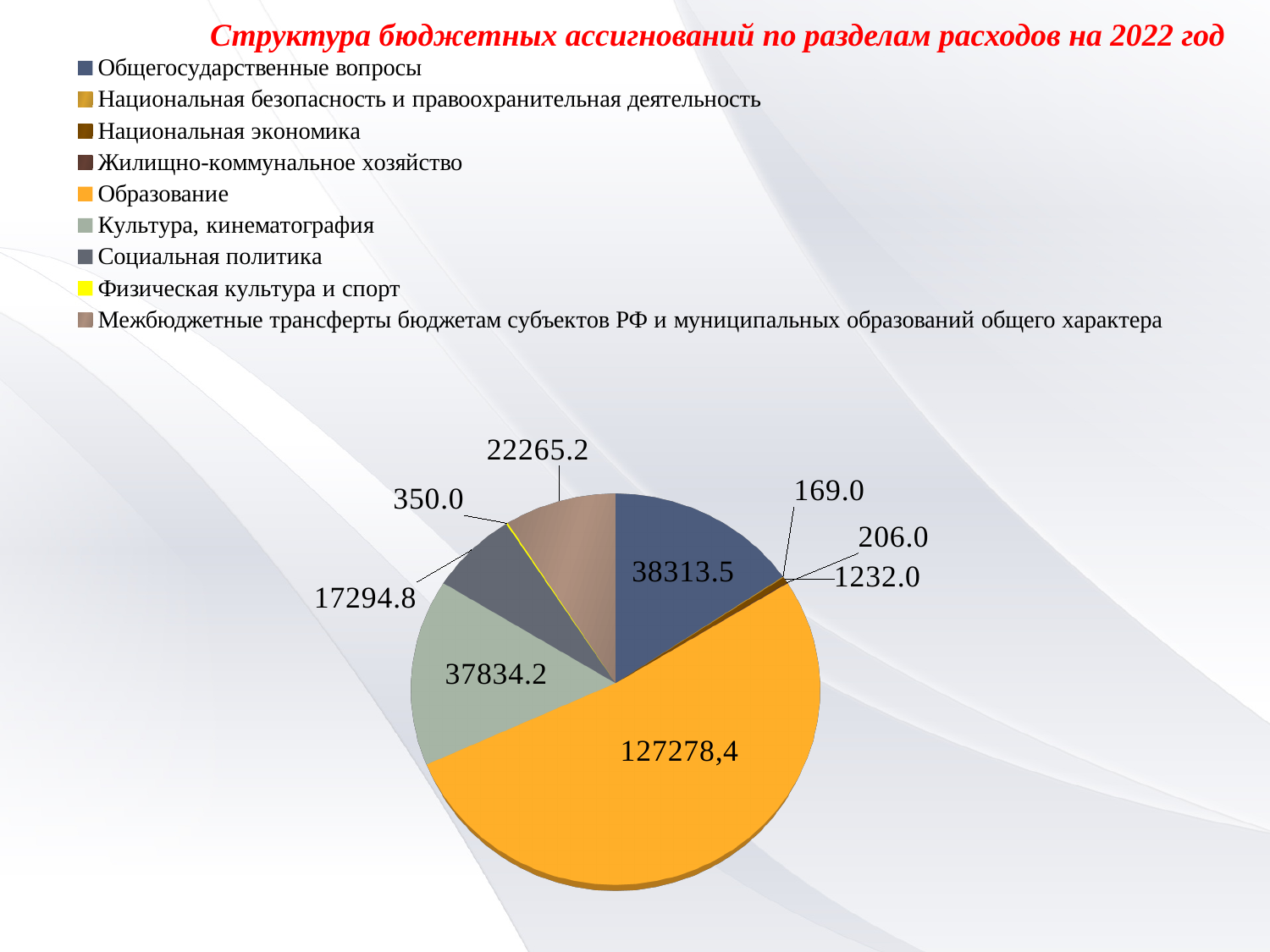
What type of chart is shown on the slide? Pie chart Which category has the largest share of the pie? Образование What is the title of the chart? Структура бюджетных ассигнований по разделам расходов на 2022 год What is the value shown for Образование? 127278,4 How many slices does the pie chart have? 9 What is the value shown for Межбюджетные трансферты бюджетам субъектов РФ и муниципальных образований общего характера? 22265.2 What is the value shown for Общегосударственные вопросы? 38313.5 What is the value shown for Социальная политика? 17294.8 Which is larger: Общегосударственные вопросы or Культура, кинематография? Общегосударственные вопросы What is the value shown for Культура, кинематография? 37834.2 What is the value shown for Физическая культура и спорт? 350.0 What is the difference between the values for Межбюджетные трансферты (22265.2) and Социальная политика (17294.8)? 4970.4